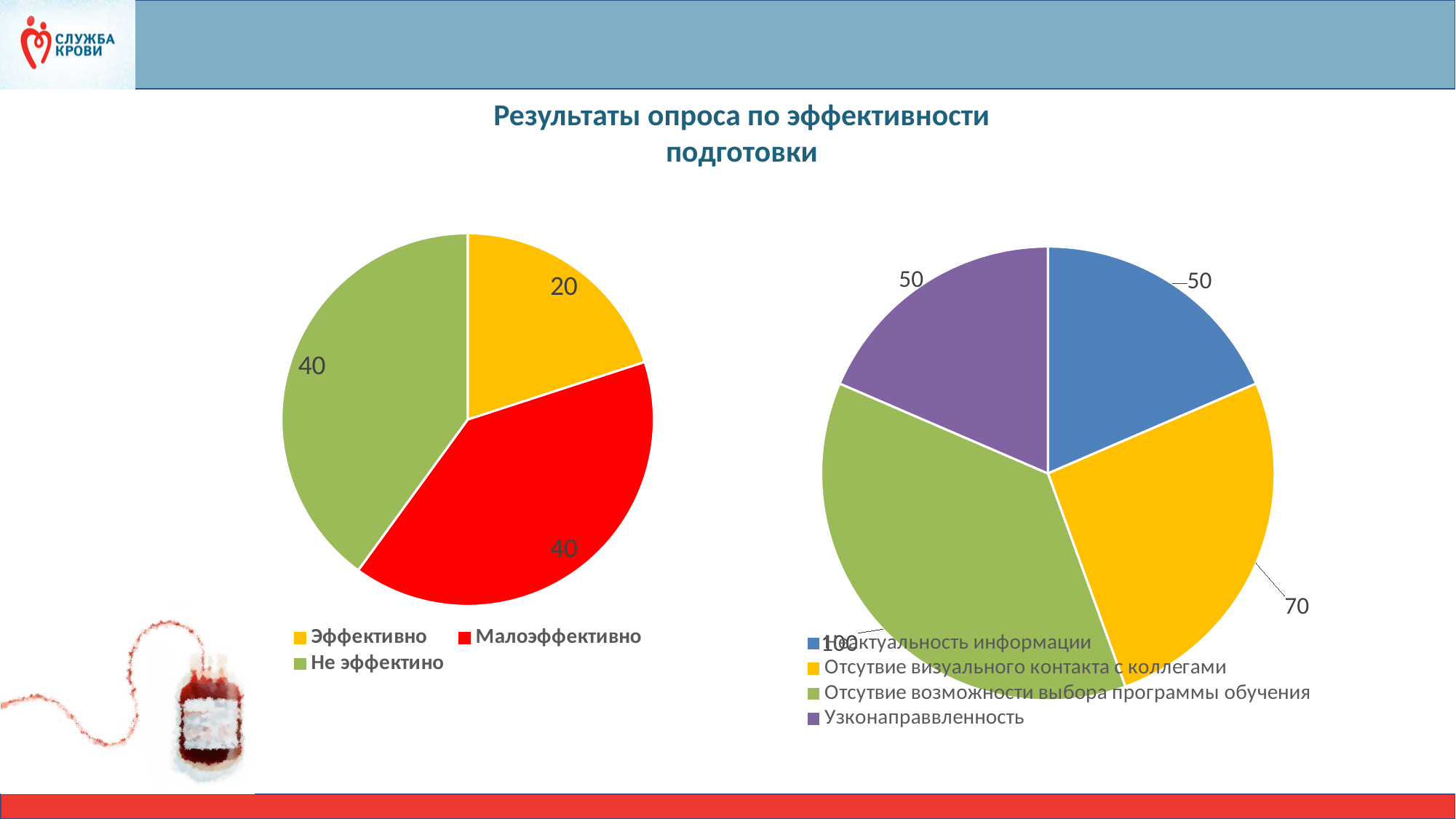
On the right pie chart, what is the value for Узконаправвленность? 50 On the left pie chart, which category has the smallest value? Эффективно How many categories does the left pie chart show? 3 On the right pie chart, which category has the largest value? Отсутвие возможности выбора программы обучения On the left pie chart, what is the value for Эффективно? 20 How many categories does the legend of the right pie chart list? 4 On the left pie chart, what share of the pie does Эффективно represent? 20% On the left pie chart, what is the value for Малоэффективно? 40 What type of chart is the left chart on the slide? Pie chart On the right pie chart, what is the value for Отсутвие визуального контакта с коллегами? 70 On the right pie chart, which is larger: Отсутвие визуального контакта с коллегами or Неактуальность информации? Отсутвие визуального контакта с коллегами On the left pie chart, what is the difference between the values for Малоэффективно and Эффективно? 20